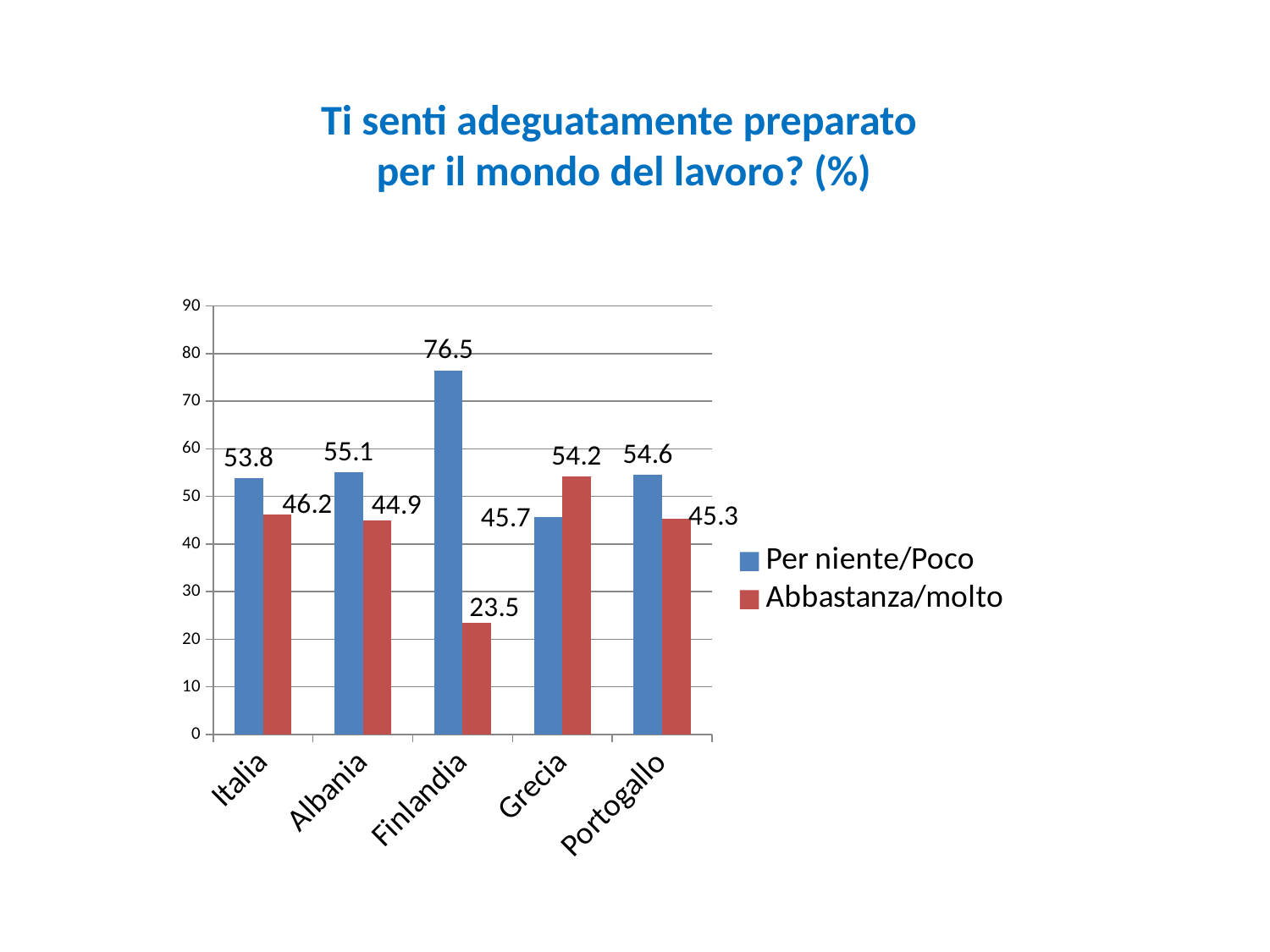
What is the value for Finlandia in the Per niente/Poco series? 76.5 What is the value for Italia in the Abbastanza/molto series? 46.2 Which country has the lowest value in the Abbastanza/molto series? Finlandia What is the value for Grecia in the Abbastanza/molto series? 54.2 What is the difference between the Per niente/Poco values for Albania and Italia? 1.3 For Grecia, which series has the larger value: Per niente/Poco or Abbastanza/molto? Abbastanza/molto What is the difference between the Per niente/Poco and Abbastanza/molto values for Finlandia? 53 How many series does the legend list? 2 What kind of chart is shown on the slide? Bar chart Which country has the highest value in the Per niente/Poco series? Finlandia Which colour represents the Abbastanza/molto series? Red How many countries are shown on the x axis? 5